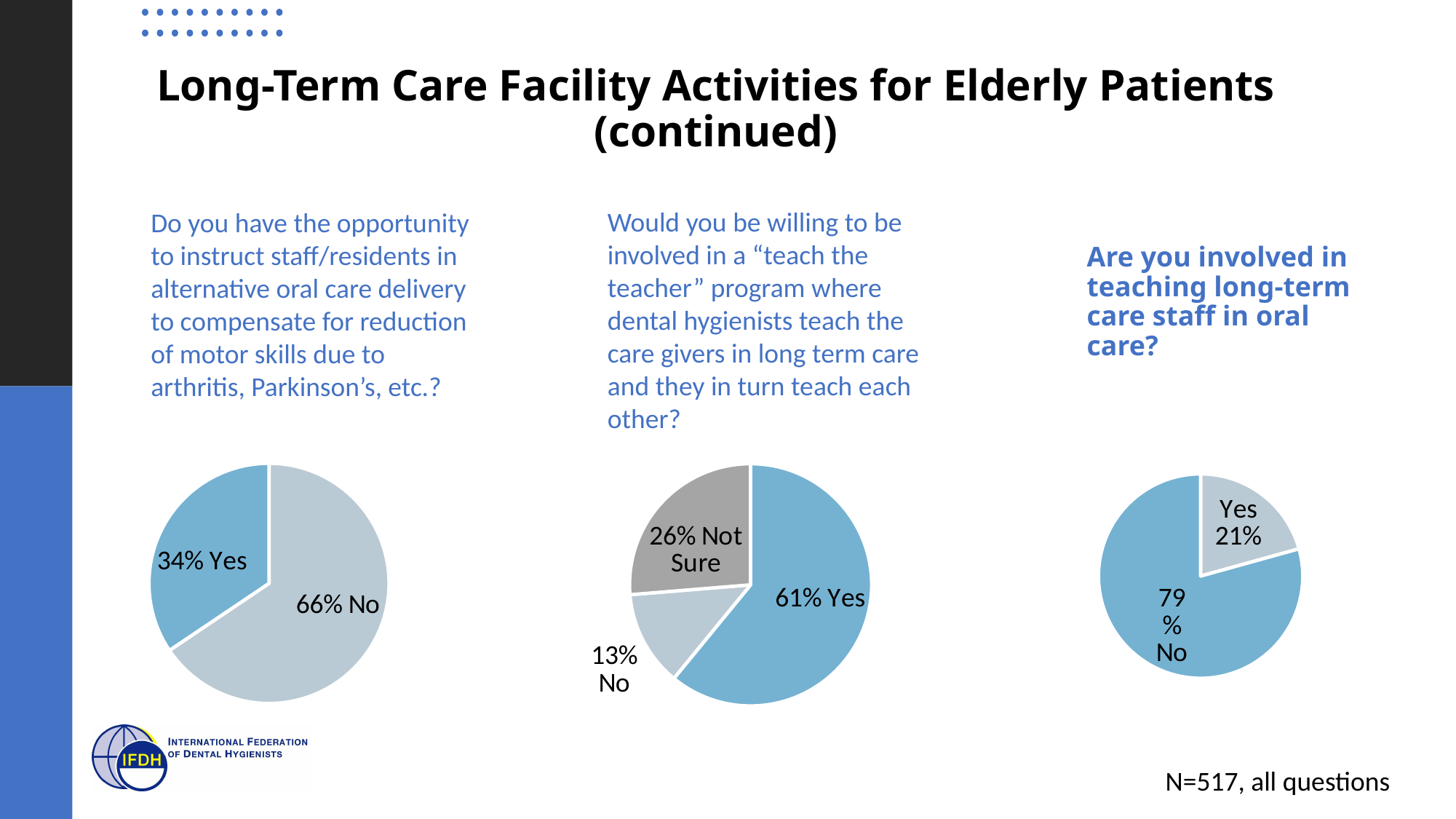
In the middle pie chart (willing to be involved in a "teach the teacher" program), which response has the smallest share? No In the left pie chart (opportunity to instruct staff/residents in alternative oral care delivery), what percentage answered Yes? 34% What type of chart is used for the right chart (involved in teaching long-term care staff in oral care)? Pie chart In the middle pie chart (willing to be involved in a "teach the teacher" program), what percentage answered Not Sure? 26% In the middle pie chart (willing to be involved in a "teach the teacher" program), what is the difference between the Yes and Not Sure shares? 35% In the left pie chart (opportunity to instruct staff/residents in alternative oral care delivery), what percentage answered No? 66% How many slices does the middle pie chart (willing to be involved in a "teach the teacher" program) have? 3 In the middle pie chart (willing to be involved in a "teach the teacher" program), what percentage answered No? 13% In the right pie chart (involved in teaching long-term care staff in oral care), what percentage answered No? 79% In the right pie chart (involved in teaching long-term care staff in oral care), what is the difference between the No and Yes shares? 58% In the left pie chart (opportunity to instruct staff/residents in alternative oral care delivery), which is larger, Yes or No? No In the middle pie chart (willing to be involved in a "teach the teacher" program), which response has the largest share? Yes